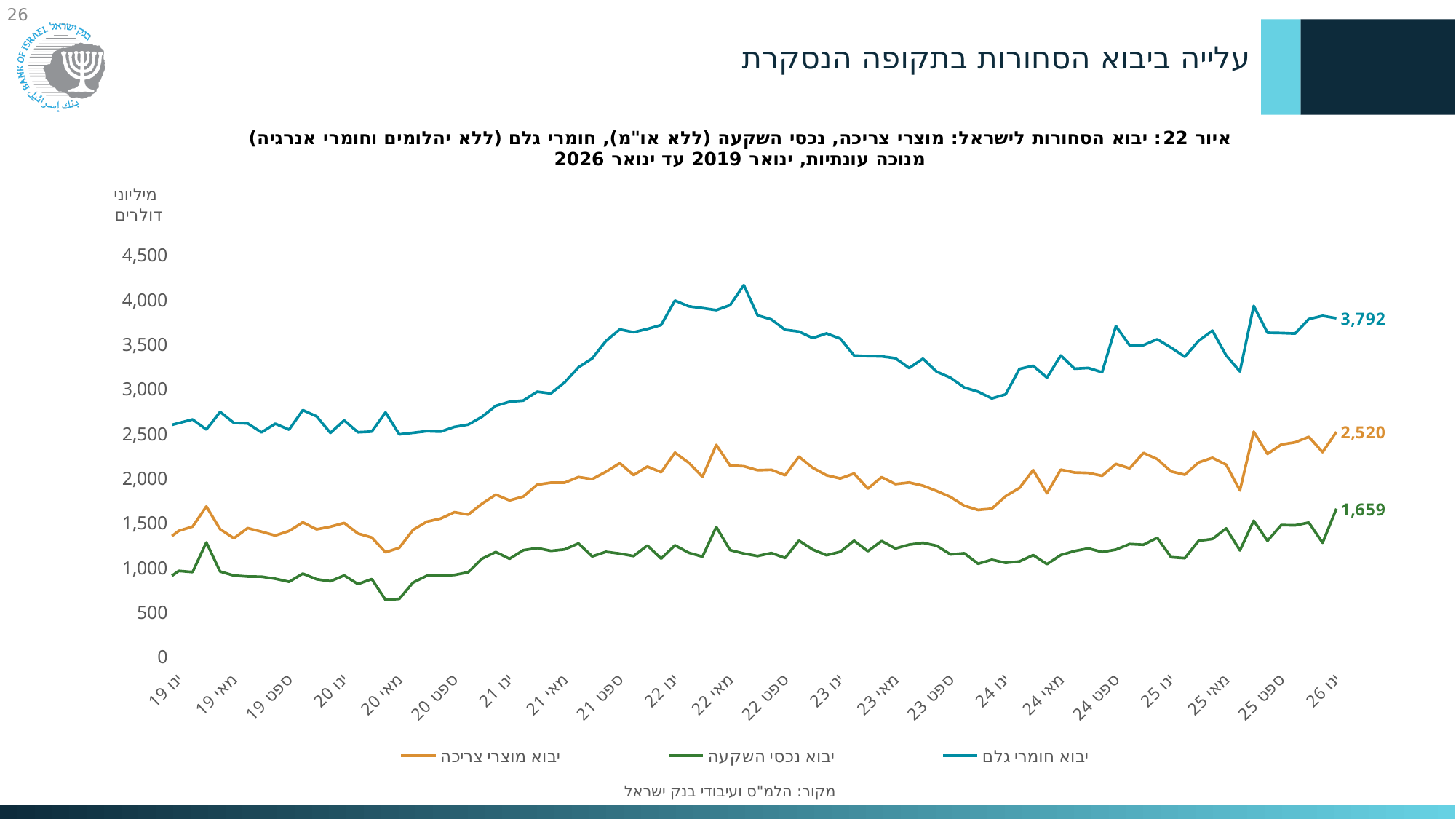
Which series has the lowest value at ינו 26? יבוא נכסי השקעה Is the value of יבוא חומרי גלם at ינו 19 greater or less than 2,000? greater What is the value of יבוא נכסי השקעה at the last point (ינו 26)? 1,659 What unit is shown on the y axis of the chart? מיליוני דולרים How many series does the legend list? 3 What is the difference between יבוא חומרי גלם and יבוא מוצרי צריכה at ינו 26? 1,272 What is the value of יבוא מוצרי צריכה at the last point (ינו 26)? 2,520 Is the value of יבוא נכסי השקעה at ינו 19 greater or less than 1,500? less What is the difference between יבוא מוצרי צריכה and יבוא נכסי השקעה at ינו 26? 861 What is the value of יבוא חומרי גלם at the last point (ינו 26)? 3,792 What type of chart is shown on the slide? line chart Which series has the highest value at ינו 26? יבוא חומרי גלם